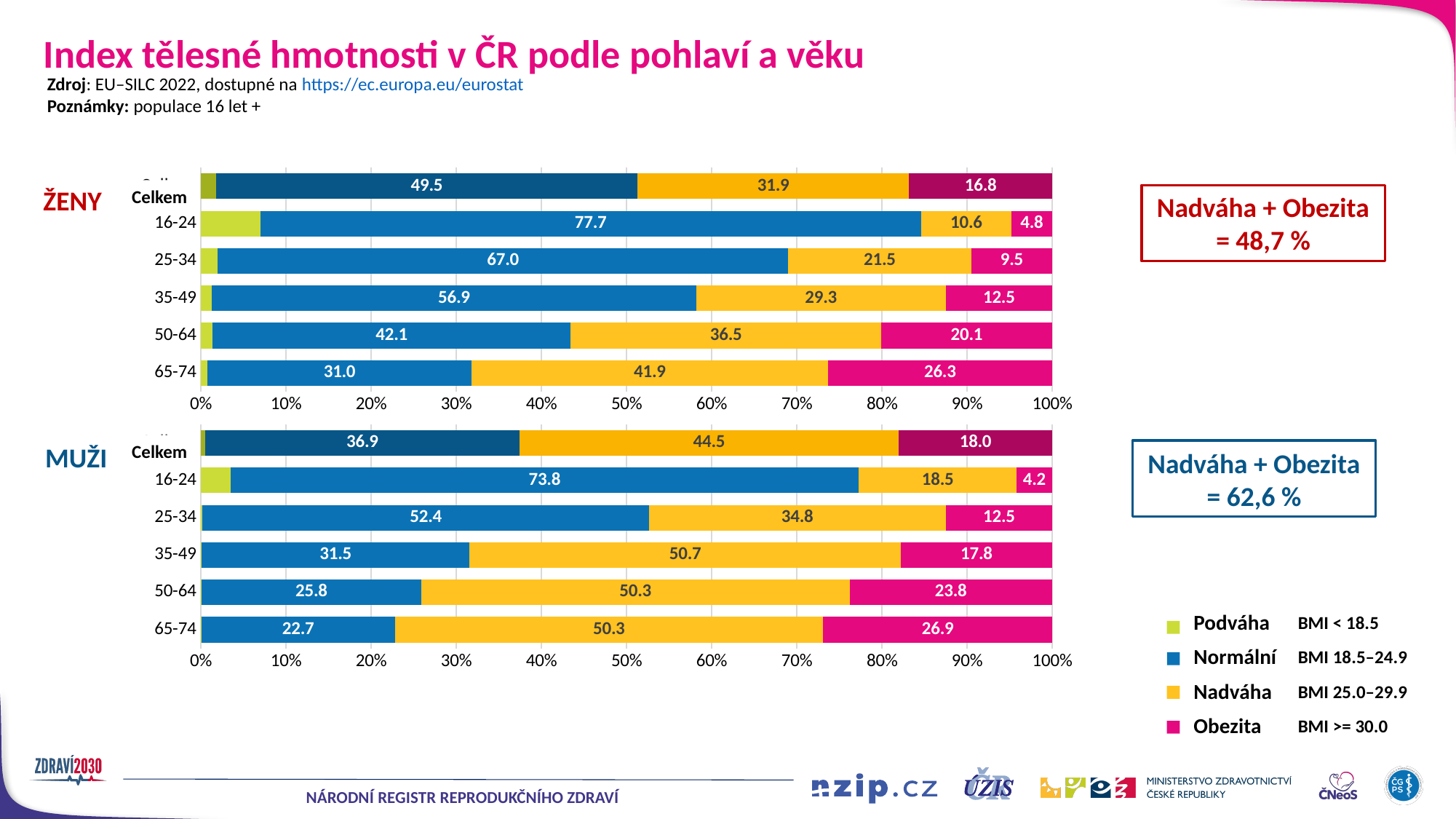
How many age-group categories (including Celkem) are shown in the MUŽI chart? 6 In the MUŽI chart, which is larger: the Normální value for 25-34 or the Nadváha value for 25-34? Normální value for 25-34 In the ŽENY chart, what is the difference between the Nadváha values for 65-74 and 16-24? 31.3 In the ŽENY chart, which age group has the highest Obezita value? 65-74 In the MUŽI chart, what is the Obezita value for Celkem? 18.0 In the MUŽI chart, do the Normální values rise or fall as the age groups go from 16-24 to 65-74? Fall How many series does the legend list? 4 In the ŽENY chart, what is the Normální value for the 16-24 age group? 77.7 In the MUŽI chart, what is the Nadváha value for the 35-49 age group? 50.7 What kind of chart is the ŽENY chart? Stacked bar chart In the MUŽI chart, which age group has the lowest Normální value? 65-74 In the ŽENY chart, is the Normální value for 50-64 greater or less than 40%? greater